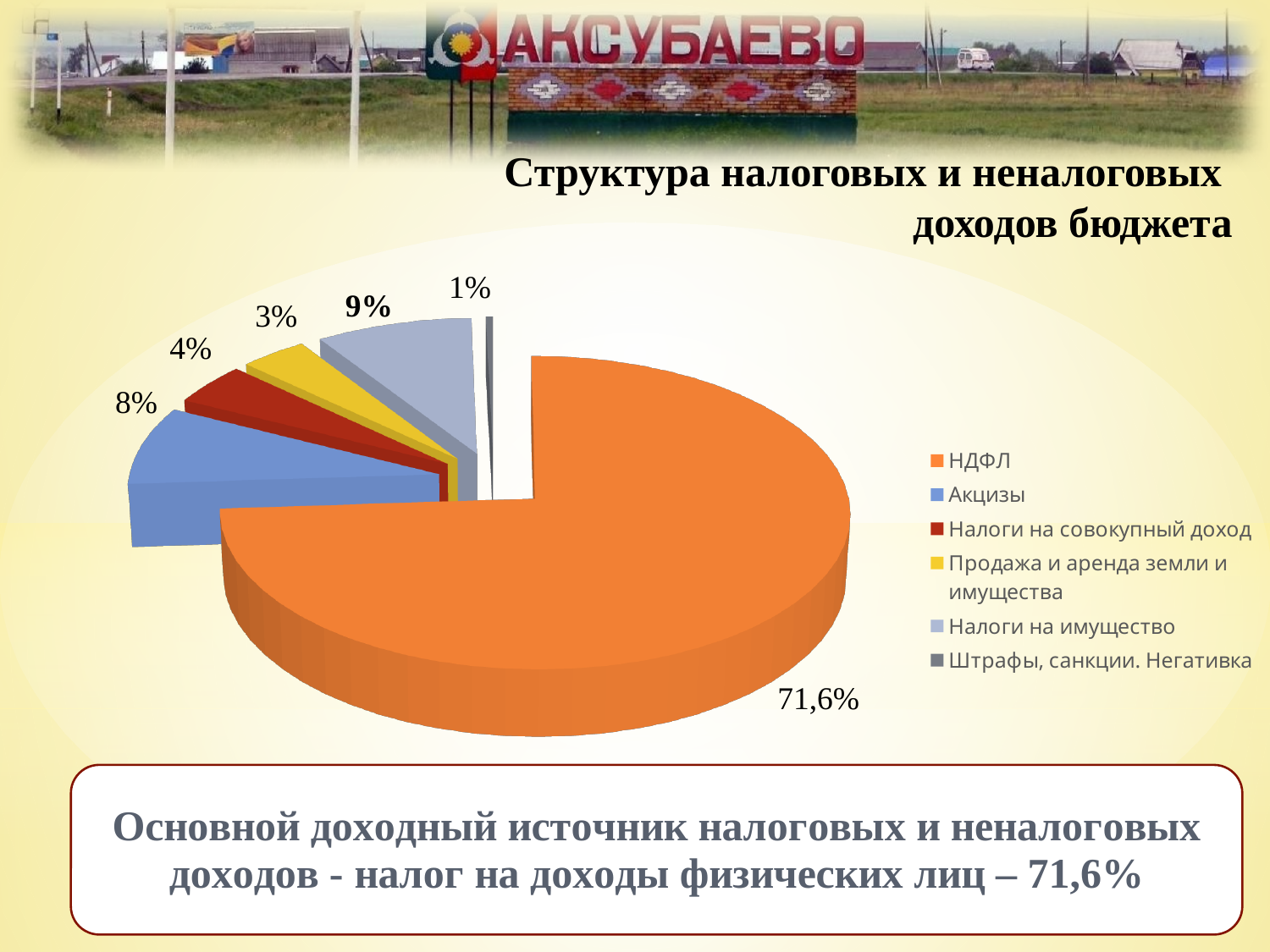
What share of the pie does НДФЛ account for? 71,6% What is the title of the chart? Структура налоговых и неналоговых доходов бюджета What type of chart is shown on the slide? pie chart How many categories does the legend list? 6 Which category has the largest share of the pie? НДФЛ What is the value shown for Налоги на имущество? 9% What is the difference between the shares for Налоги на имущество and Акцизы? 1% Which is larger, the share for Акцизы or the share for Налоги на имущество? Налоги на имущество What is the value shown for Акцизы? 8% What is the value shown for Налоги на совокупный доход? 4% Which category has the smallest share of the pie? Штрафы, санкции. Негативка What is the value shown for Продажа и аренда земли и имущества? 3%